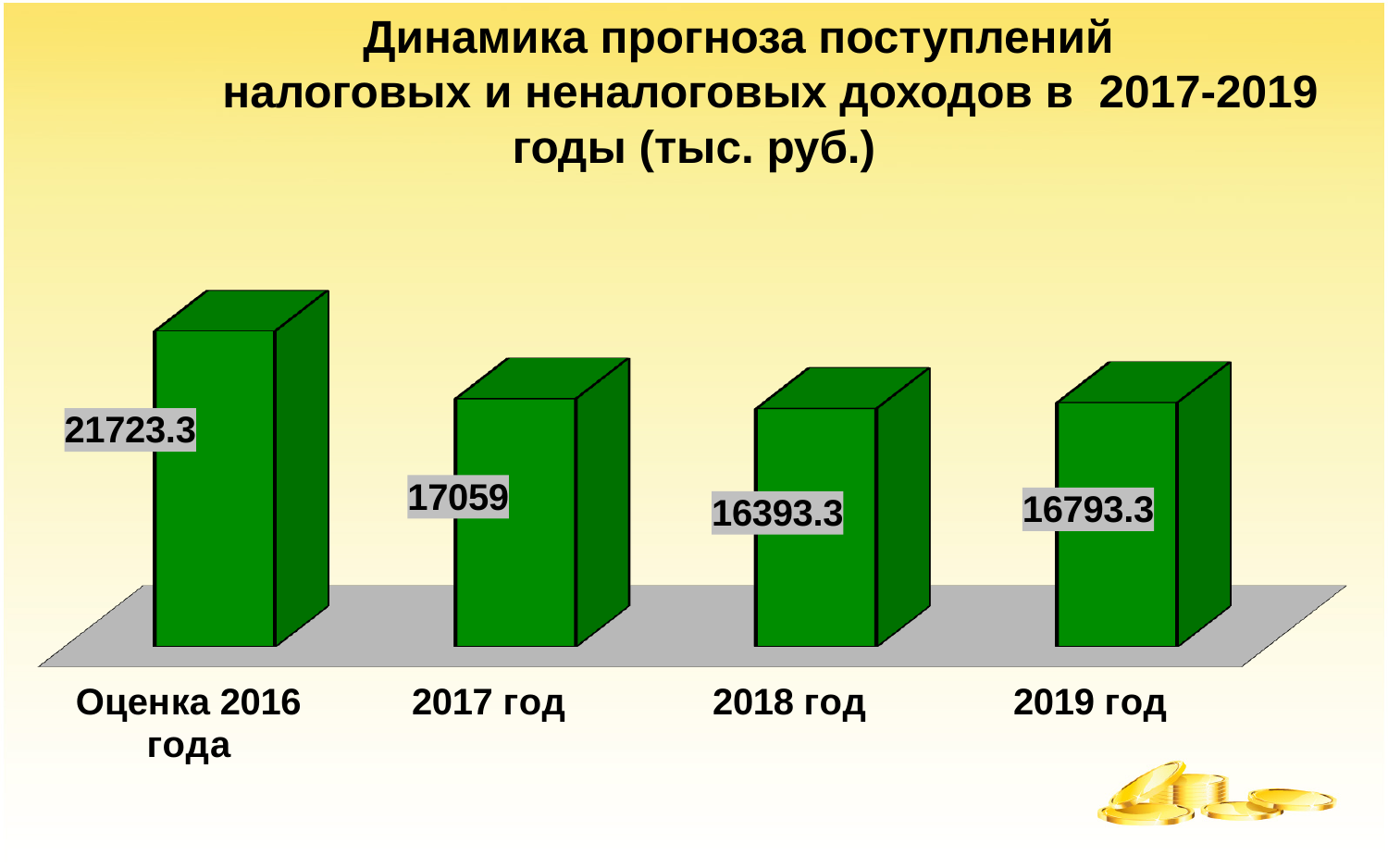
What is the value for Оценка 2016 года? 21723.3 Do the values rise or fall from Оценка 2016 года to 2018 год? Fall Which category has the highest value? Оценка 2016 года What is the value for 2019 год? 16793.3 Which is larger, the value for 2017 год or the value for 2019 год? 2017 год What is the value for 2017 год? 17059 What is the value for 2018 год? 16393.3 How many categories are shown on the chart? 4 What kind of chart is shown on the slide? Bar chart Which category has the lowest value? 2018 год What is the difference between the values for Оценка 2016 года and 2017 год? 4664.3 What is the difference between the values for 2019 год and 2018 год? 400